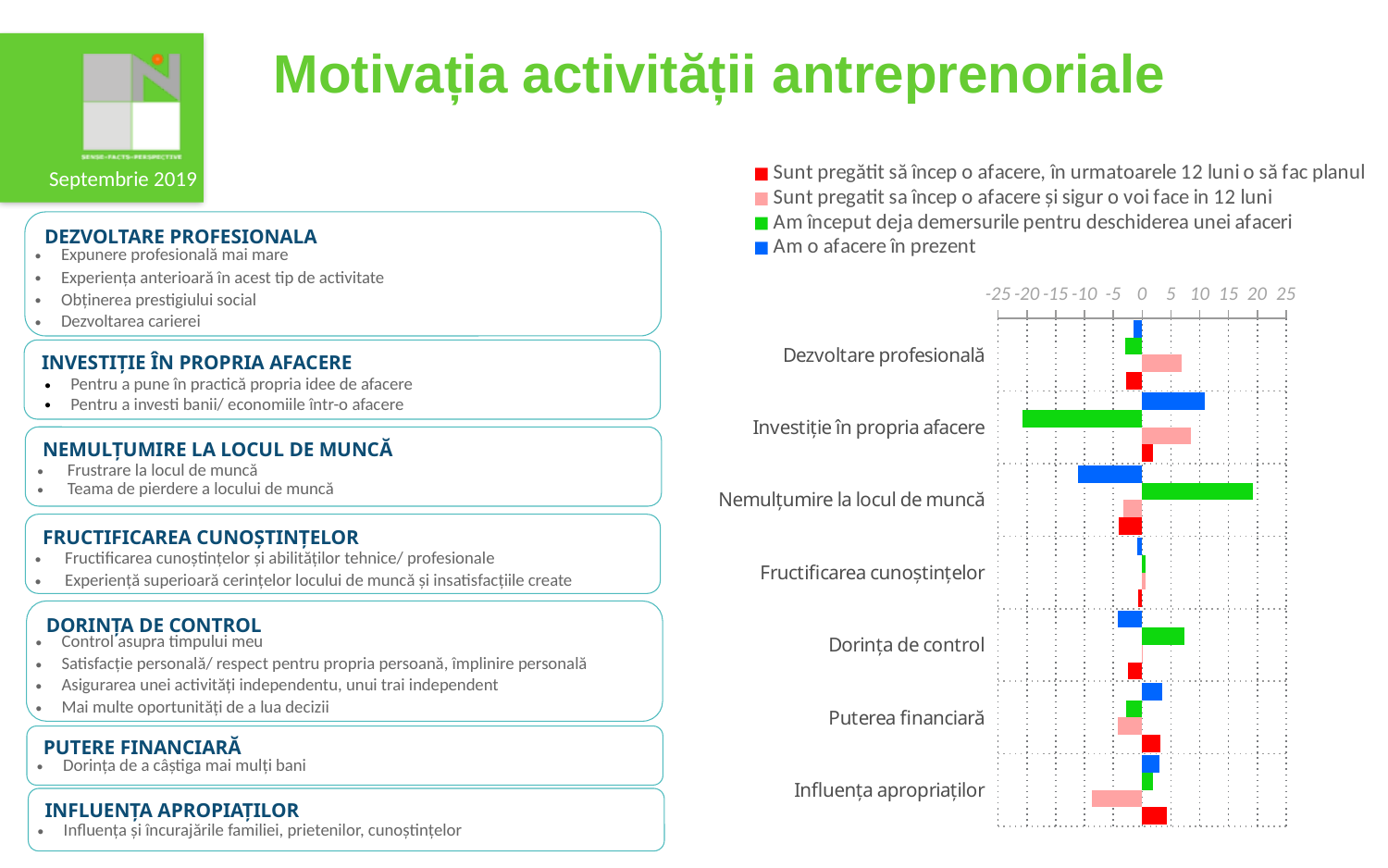
Which category has the lowest (most negative) value for the series 'Am o afacere în prezent'? Nemulțumire la locul de muncă How many categories are shown on the chart's vertical axis? 7 Which category has the highest value for the series 'Am început deja demersurile pentru deschiderea unei afaceri'? Nemulțumire la locul de muncă Which category has the lowest (most negative) value for the series 'Am început deja demersurile pentru deschiderea unei afaceri'? Investiție în propria afacere Is the value of 'Am început deja demersurile pentru deschiderea unei afaceri' for Investiție în propria afacere greater or less than -15? less How many series does the chart legend list? 4 For the series 'Am o afacere în prezent', which is larger: the value for Investiție în propria afacere or the value for Puterea financiară? Investiție în propria afacere What kind of chart is shown on the slide? bar chart Is the value of 'Am început deja demersurile pentru deschiderea unei afaceri' for Nemulțumire la locul de muncă greater or less than 15? greater Is the value of 'Am o afacere în prezent' for Nemulțumire la locul de muncă greater or less than -5? less Which category has the lowest (most negative) value for the series 'Sunt pregatit sa încep o afacere și sigur o voi face in 12 luni'? Influența apropriaților Which category has the highest value for the series 'Am o afacere în prezent'? Investiție în propria afacere